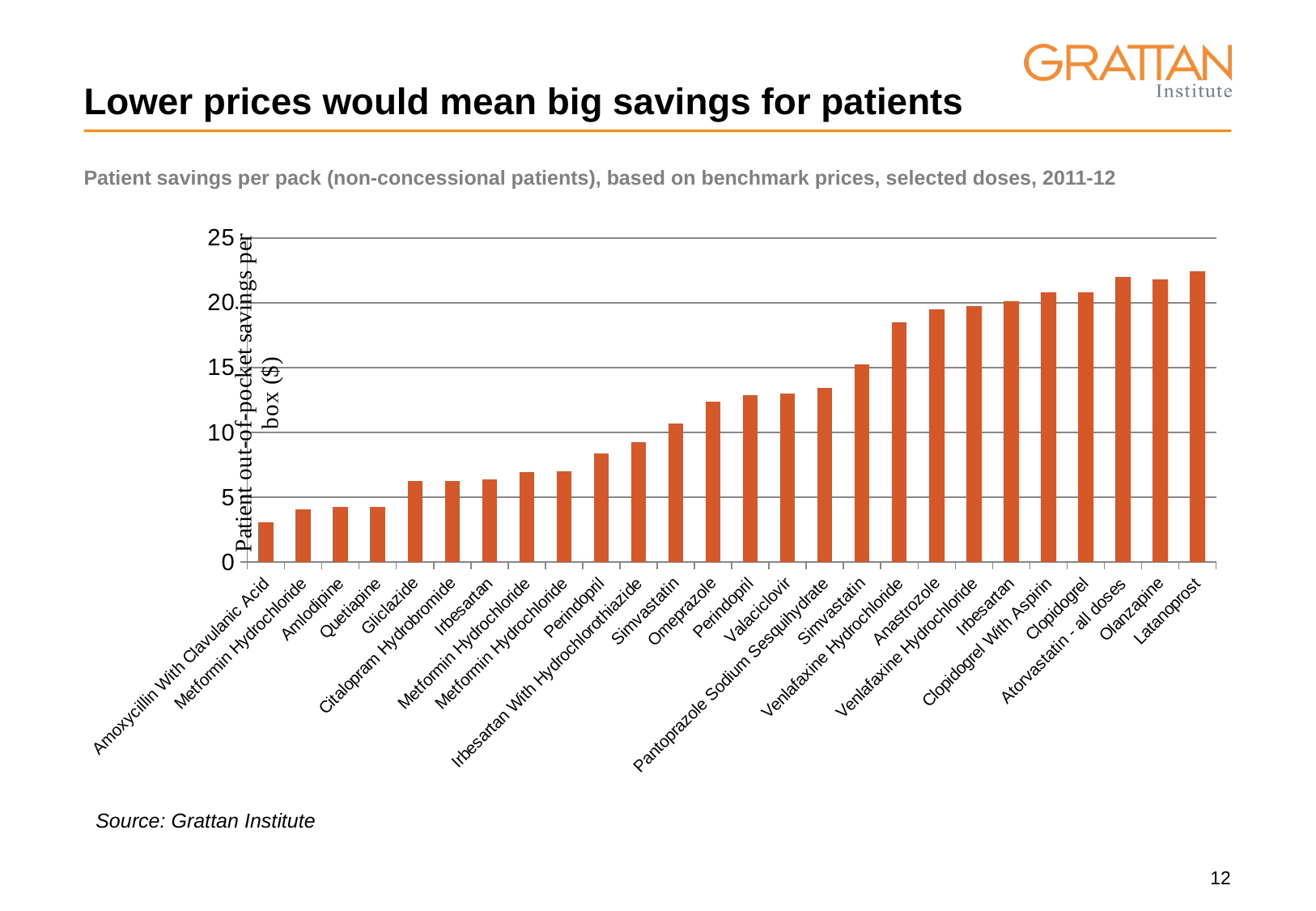
Is the value for Valaciclovir greater or less than 15? less Which is larger, the value for Olanzapine or the value for Quetiapine? Olanzapine Is the value for Amoxycillin With Clavulanic Acid greater or less than 5? less Which drug has the lowest patient out-of-pocket savings per box? Amoxycillin With Clavulanic Acid Do the values generally rise or fall moving from left to right along the x axis? Rise Which drug has the highest patient out-of-pocket savings per box? Latanoprost Is the value for Latanoprost greater or less than 20? greater What is the label on the vertical axis of the chart? Patient out-of-pocket savings per box ($) What kind of chart is shown on the slide? Bar chart How many bars (drugs) are plotted in the chart? 26